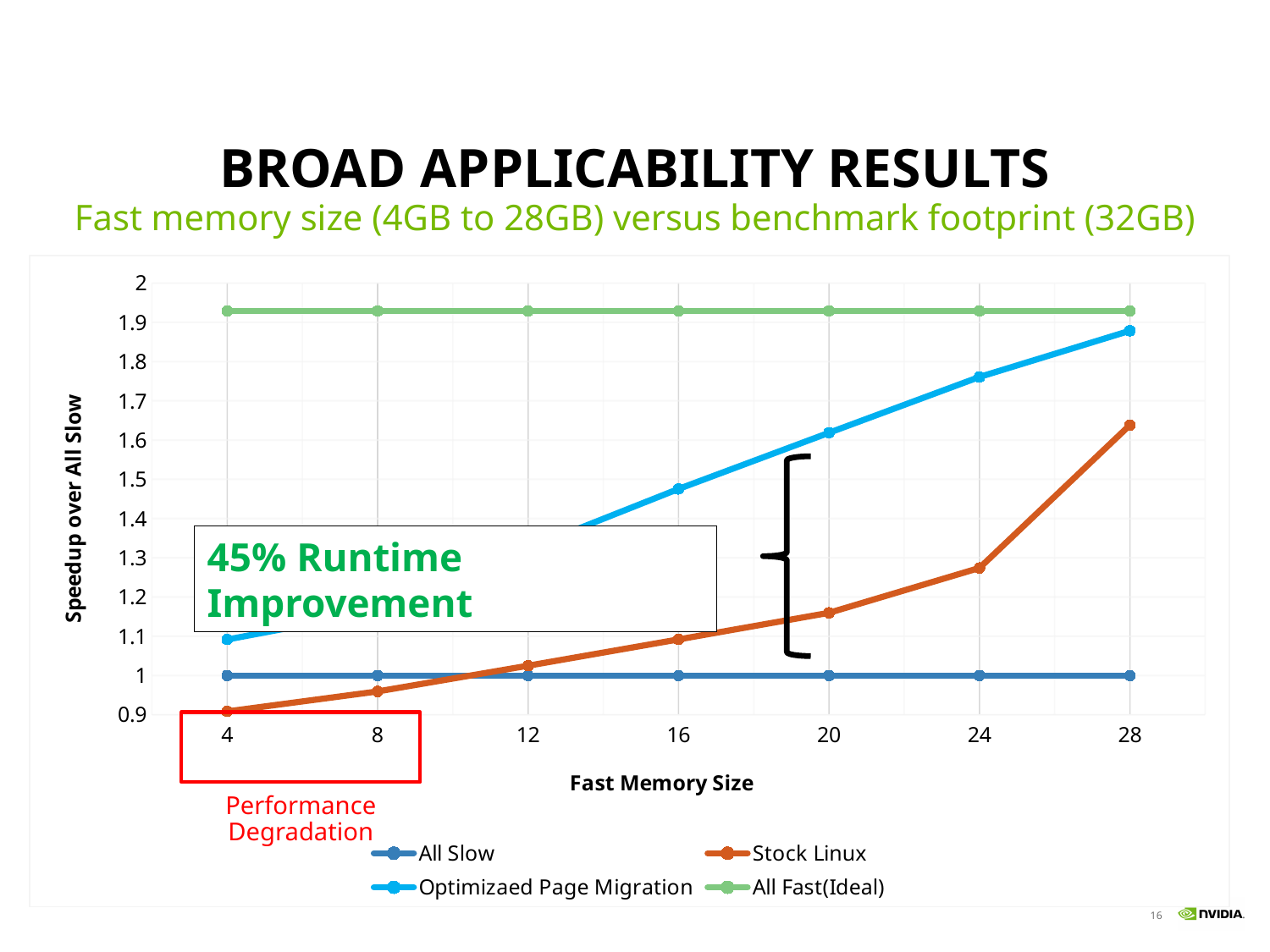
Is the value for Optimizaed Page Migration at a fast memory size of 28 greater or less than 1.8? greater How many series does the legend list? 4 At a fast memory size of 28, which is larger: Optimizaed Page Migration or Stock Linux? Optimizaed Page Migration What is the speedup value for All Slow at a fast memory size of 16? 1 Is the value for Stock Linux at a fast memory size of 4 greater or less than 1? less Which series has the highest value at a fast memory size of 20? All Fast(Ideal) How many fast memory size values are plotted along the x axis? 7 Does the Stock Linux series rise or fall as fast memory size increases? rise Is the value for Stock Linux at a fast memory size of 24 greater or less than 1.4? less Which series has the lowest value at a fast memory size of 4? Stock Linux What kind of chart is shown on the slide? line chart